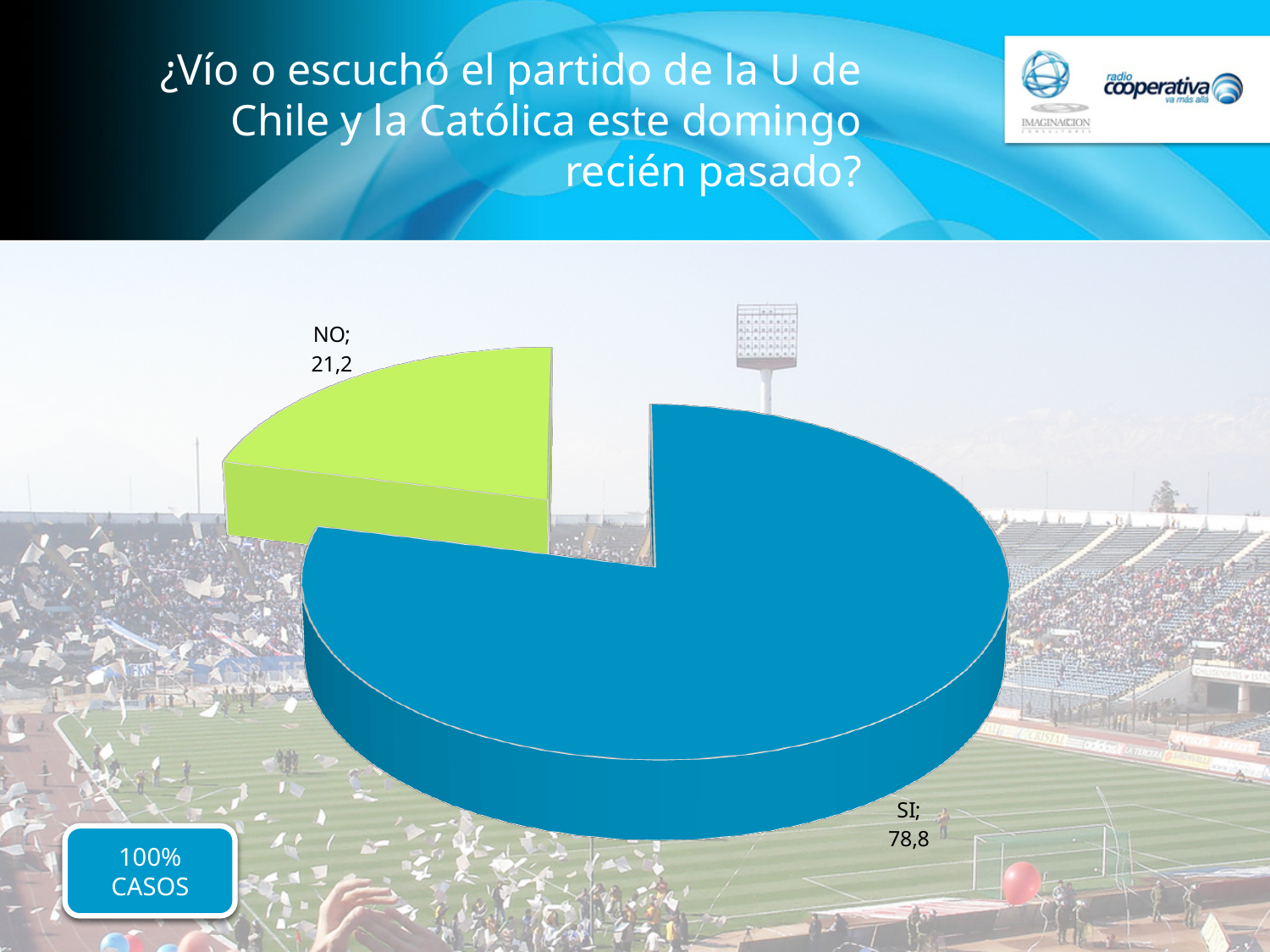
Which category has the smallest slice? NO What colour is the SI slice? blue Which category has the largest slice? SI What is the total of the two slice values? 100 What is the difference between the values for SI and NO? 57,6 How many slices does the pie chart have? 2 Which is larger, the value for SI or the value for NO? SI What is the value for SI? 78,8 What kind of chart is shown on the slide? pie chart What colour is the NO slice? green What is the value for NO? 21,2